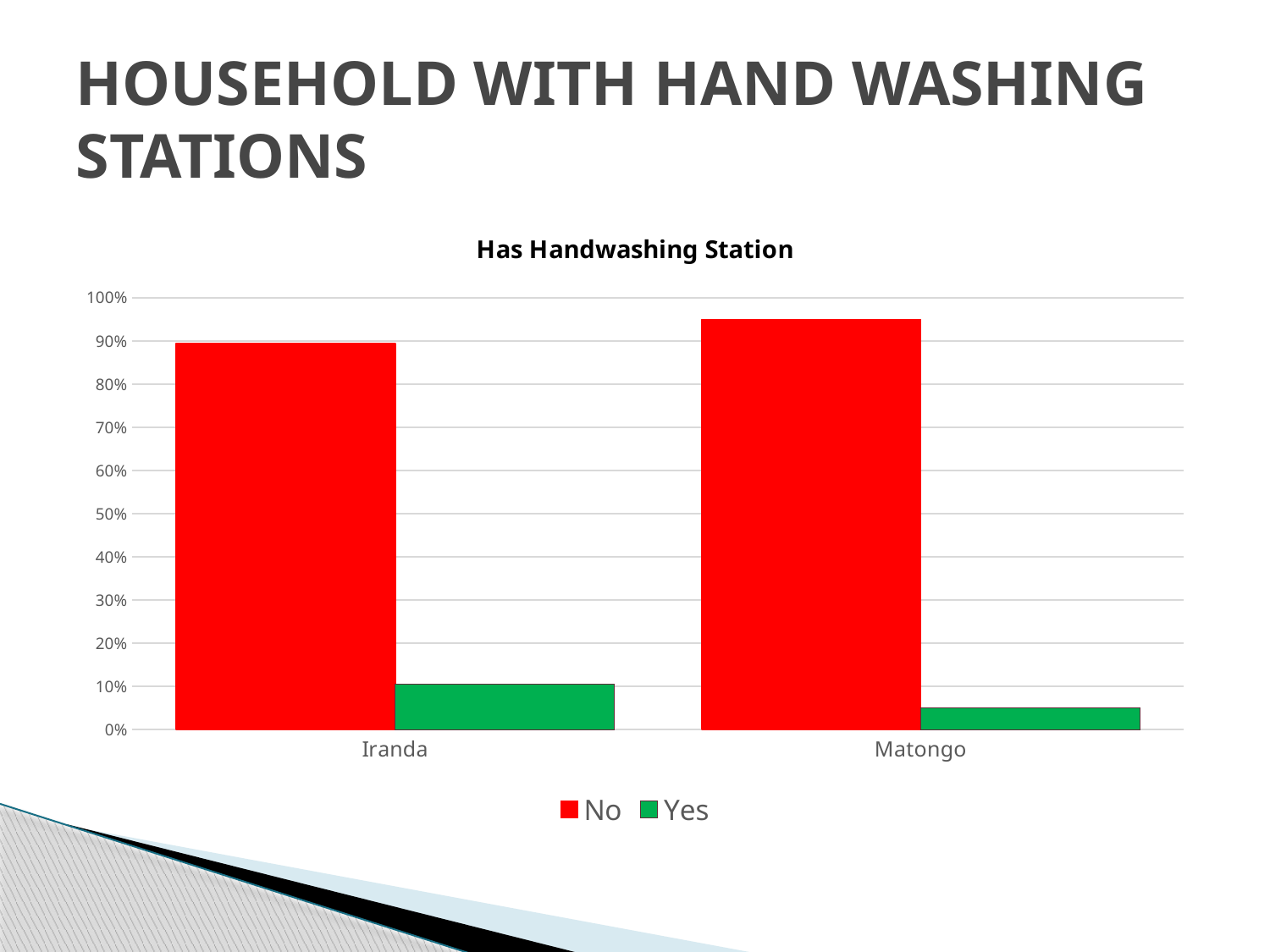
Is the "No" value for Matongo greater or less than 90%? greater How many series does the legend list? 2 Is the "No" value for Iranda greater or less than 80%? greater Which category has the larger "Yes" value, Iranda or Matongo? Iranda What is the title of the chart? Has Handwashing Station Is the "Yes" value for Matongo greater or less than 10%? less Which category has the higher "No" value? Matongo Which colour represents the "No" series? red How many categories are shown on the x axis? 2 Which category has the lowest "Yes" value? Matongo What kind of chart is shown on the slide? bar chart